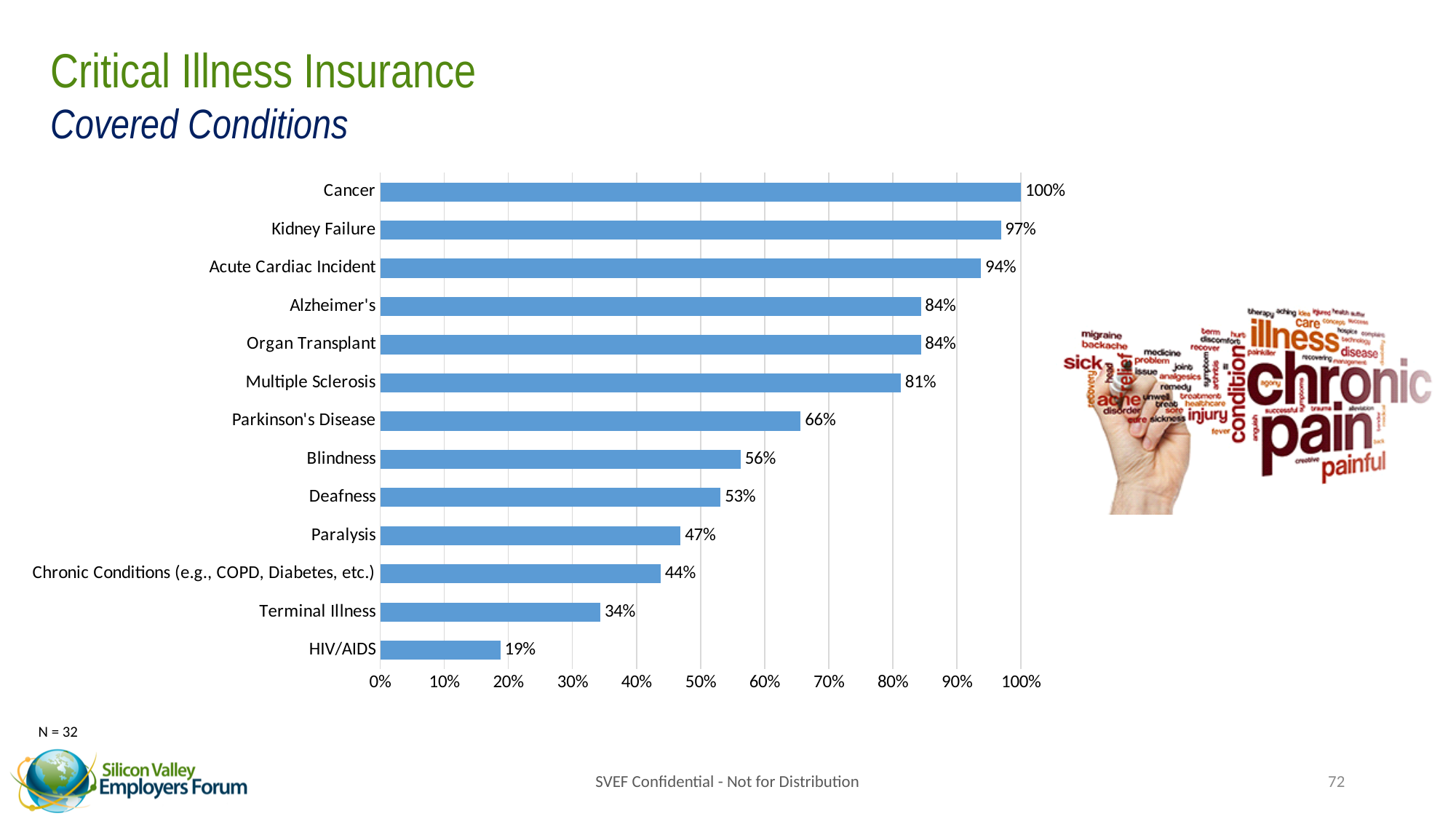
What percentage of plans cover Cancer? 100% What type of chart is shown on the slide? Bar chart Which condition has the highest coverage percentage? Cancer What is the value shown for Chronic Conditions (e.g., COPD, Diabetes, etc.)? 44% What is the sample size noted below the chart? N = 32 What is the value shown for Parkinson's Disease? 66% Is the value for Acute Cardiac Incident greater or less than 90%? greater What is the difference between the values for Blindness and Deafness? 3% What is the difference between the values for Kidney Failure and Terminal Illness? 63% How many conditions are listed in the chart? 13 Which has a higher value, Multiple Sclerosis or Paralysis? Multiple Sclerosis Which condition has the lowest coverage percentage? HIV/AIDS